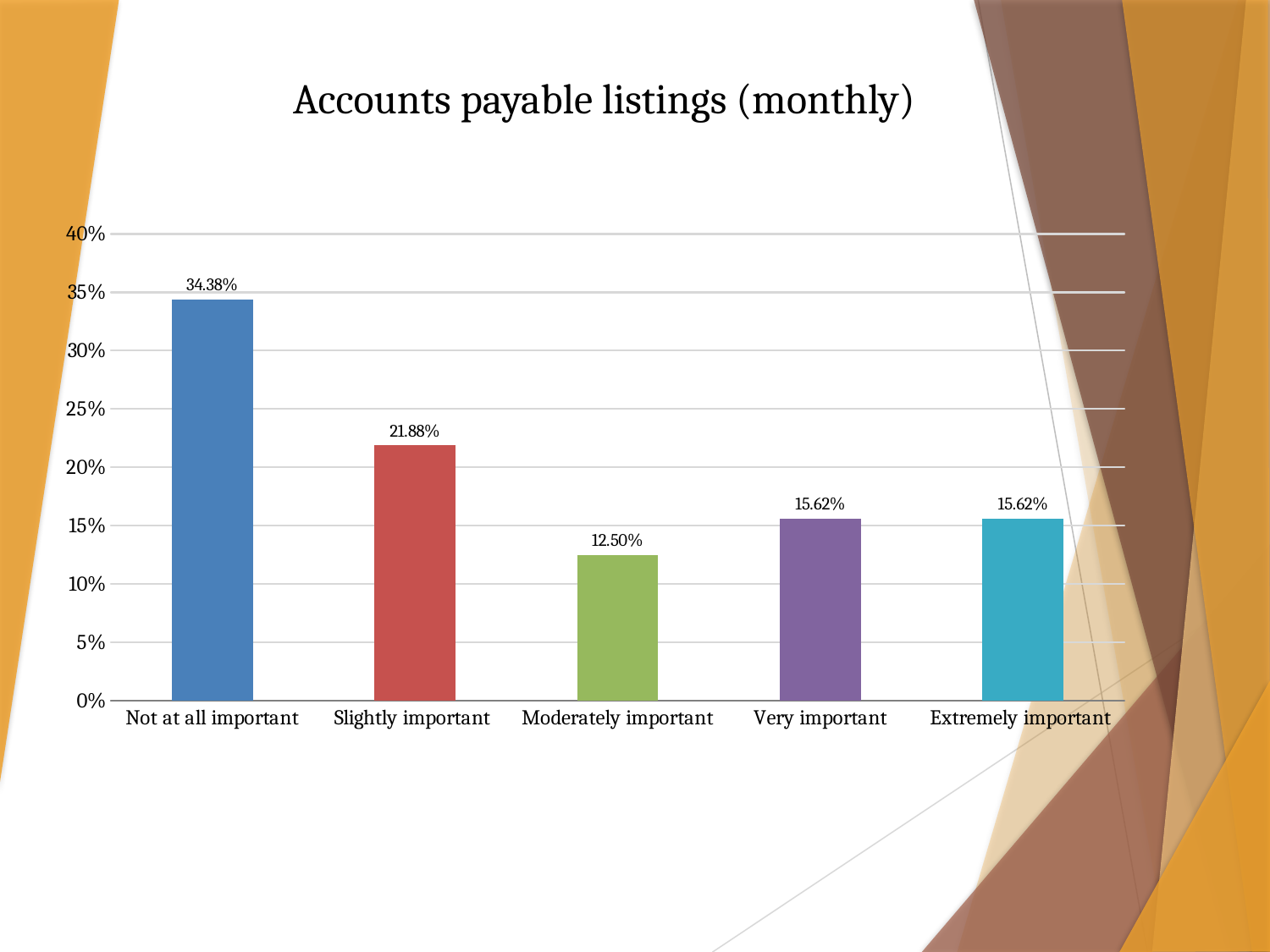
What is the title of the chart? Accounts payable listings (monthly) Which category has the highest value? Not at all important What is the value for Very important? 15.62% Which category has the lowest value? Moderately important Which is larger, the value for Slightly important or the value for Very important? Slightly important What is the value for Not at all important? 34.38% How many categories are shown on the x axis? 5 What kind of chart is shown on the slide? bar chart What is the difference between the values for Not at all important and Slightly important? 12.50% What is the value for Slightly important? 21.88% What is the value for Moderately important? 12.50% Is the value for Moderately important greater or less than 15%? less